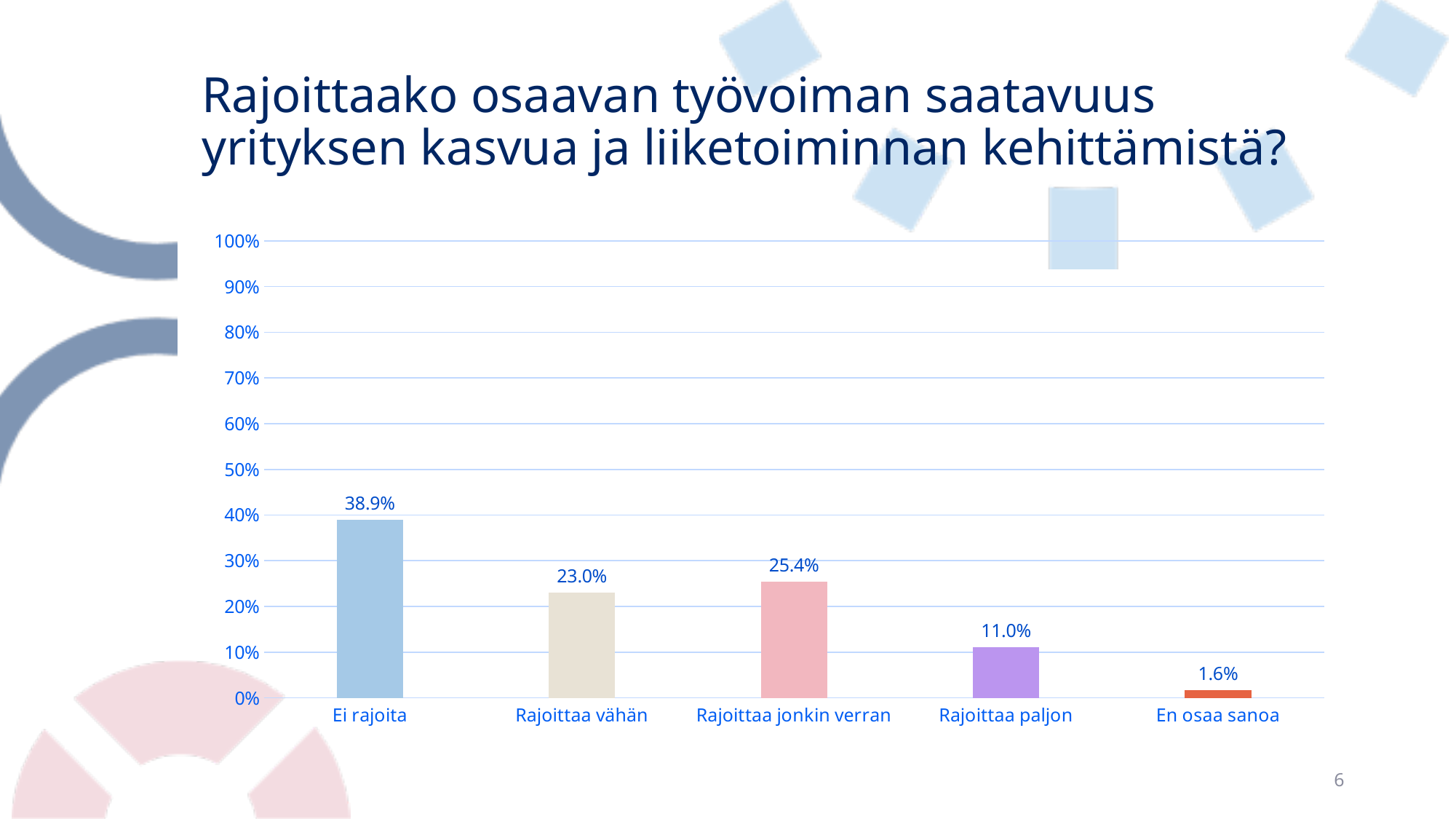
Which is larger, the value for "Rajoittaa vähän" or "Rajoittaa jonkin verran"? Rajoittaa jonkin verran How many categories are shown on the x axis? 5 Is the value for "Ei rajoita" greater or less than 30%? greater What is the value for "En osaa sanoa"? 1.6% What is the value for "Rajoittaa jonkin verran"? 25.4% Which category has the highest value? Ei rajoita What is the value for "Ei rajoita"? 38.9% What is the value for "Rajoittaa paljon"? 11.0% What is the difference between the values for "Ei rajoita" and "Rajoittaa vähän"? 15.9% What kind of chart is shown on the slide? bar chart What is the title of the slide? Rajoittaako osaavan työvoiman saatavuus yrityksen kasvua ja liiketoiminnan kehittämistä? Which category has the lowest value? En osaa sanoa